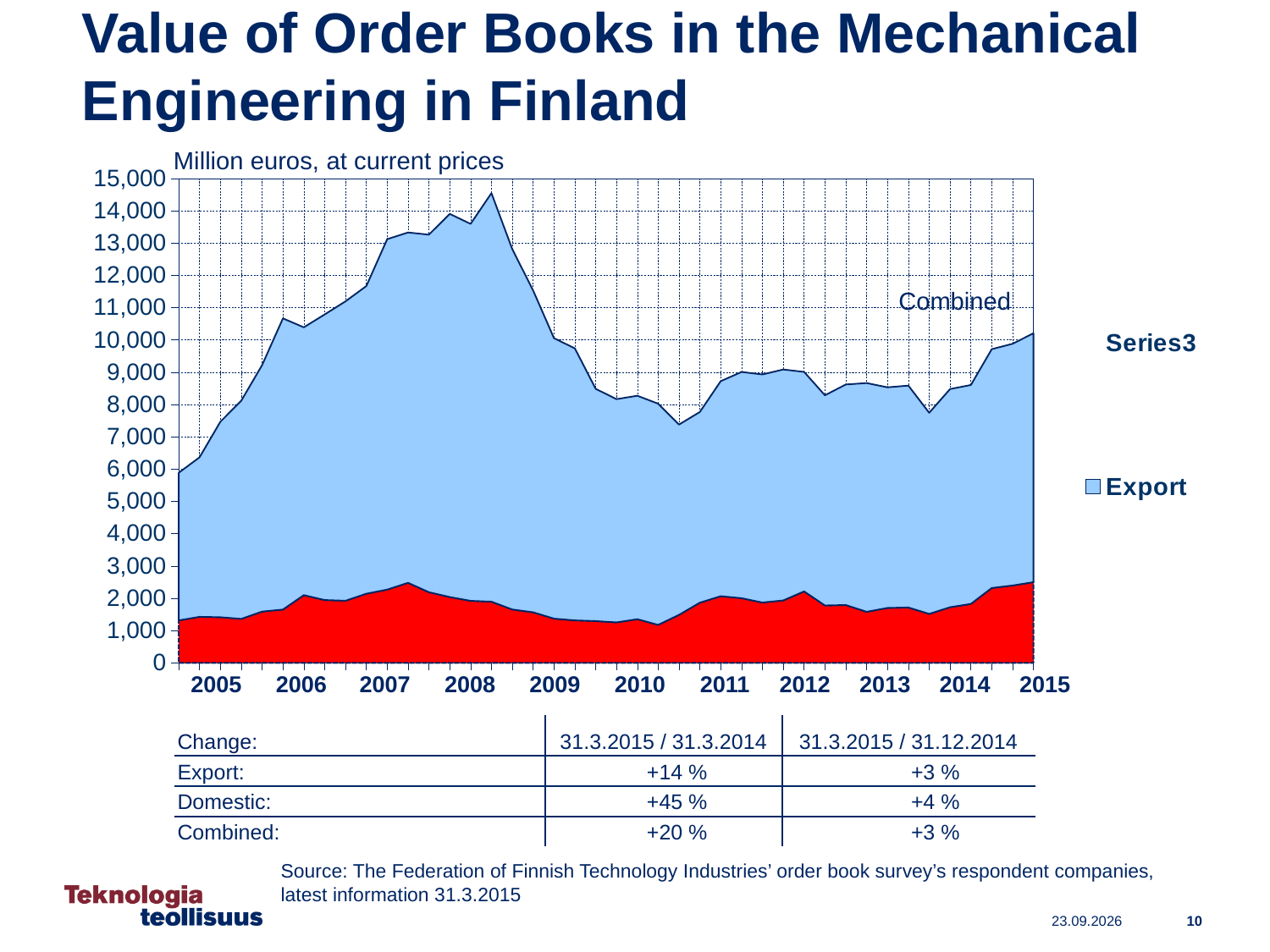
What are the two entries in the chart legend? Series3 and Export In which year does the combined order book value reach its highest peak? 2008 How many year labels are shown on the x axis? 11 Is the combined value at the start of 2005 greater or less than 7,000? less What unit label is shown above the chart? Million euros, at current prices What kind of chart is shown on the slide? Area chart In which year is the combined order book value at its lowest? 2005 Is the combined value at the end of the series in 2015 greater or less than 9,000? greater How many series does the chart legend list? 2 Does the combined order book value rise or fall between 2008 and 2010? fall Does the combined order book value rise or fall between 2005 and 2008? rise Is the peak combined value in 2008 greater or less than 14,000? greater